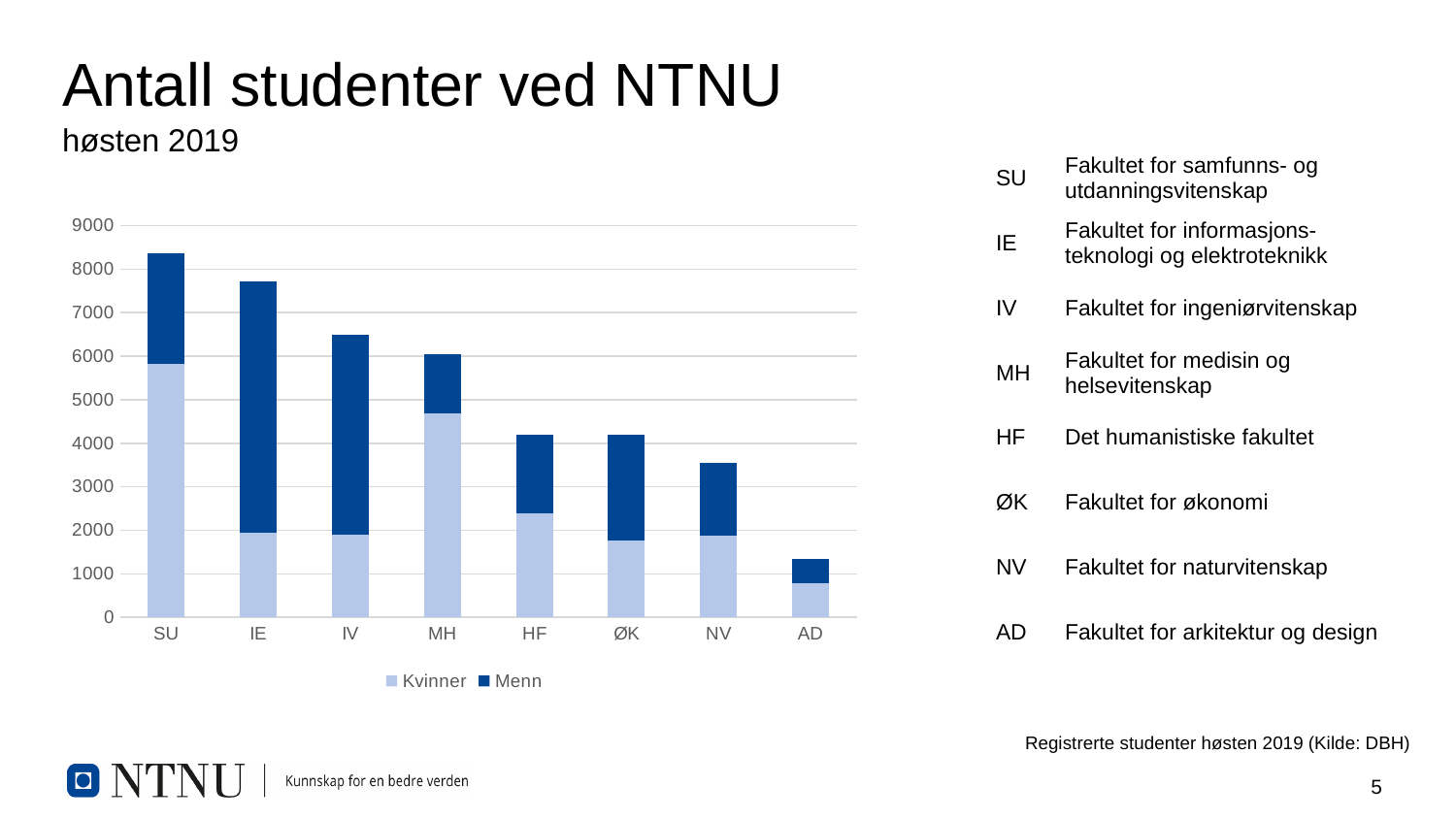
Do the total bar heights generally rise or fall from left to right along the x axis? fall Is the Kvinner value for MH greater or less than 4000? greater Which faculty has the lowest total number of students in the chart? AD How many series does the chart's legend list? 2 Which has more students in total, SU or IE? SU Is the Kvinner value for IE greater or less than 3000? less What kind of chart is shown on the slide? Stacked bar chart Which faculty has the highest total number of students in the chart? SU What are the two series named in the chart's legend? Kvinner and Menn How many faculties (categories) are shown on the x axis of the chart? 8 Is the total number of students for AD greater or less than 2000? less